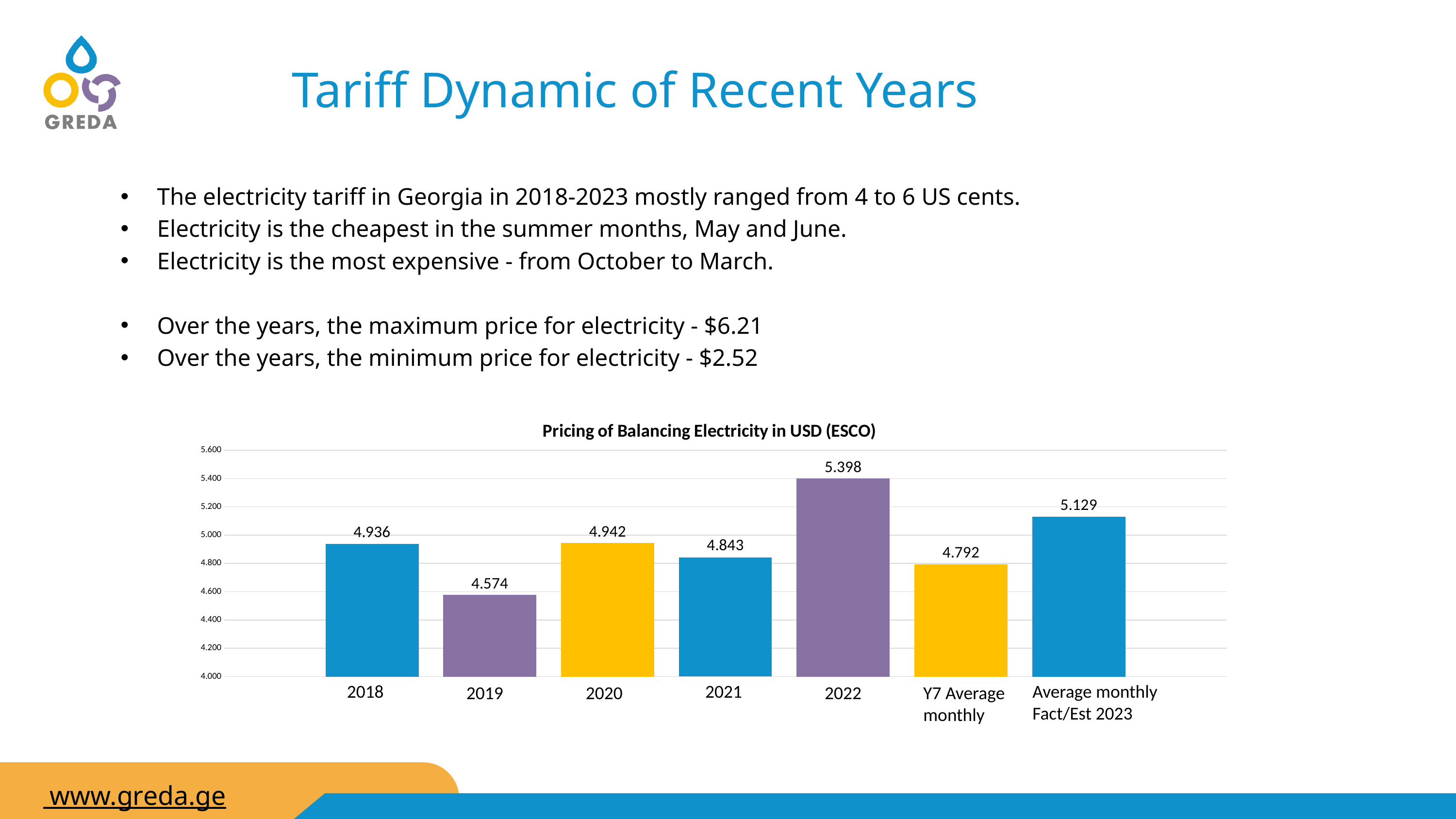
What is the value for 2022 in the chart? 5.398 What is the difference between the values for 2022 and 2019? 0.824 What is the difference between the value for Average monthly Fact/Est 2023 and Y7 Average monthly? 0.337 What is the value for 2019 in the chart? 4.574 What is the value for Y7 Average monthly in the chart? 4.792 Is the value for 2021 greater or less than 5.000? less Which category has the lowest value in the chart? 2019 Which category has the highest value in the chart? 2022 Which is larger, the value for 2021 or the value for 2022? 2022 What is the value for Average monthly Fact/Est 2023? 5.129 How many bars are shown in the chart? 7 What is the title of the chart? Pricing of Balancing Electricity in USD (ESCO)